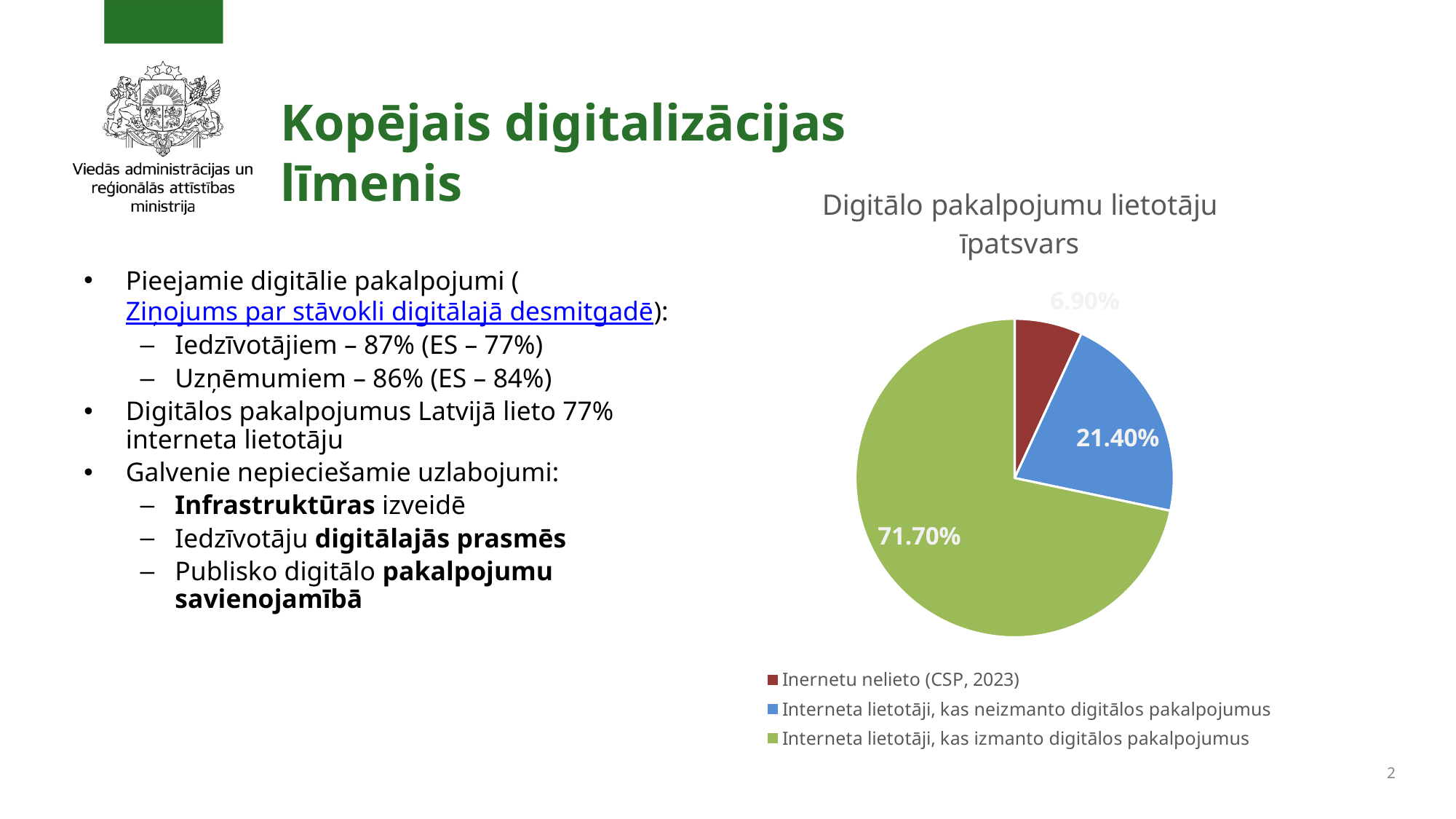
How many slices does the pie chart have? 3 What colour is the slice for 'Interneta lietotāji, kas izmanto digitālos pakalpojumus'? green What is the title of the chart? Digitālo pakalpojumu lietotāju īpatsvars How many entries does the legend list? 3 Which is larger: the slice for 'Interneta lietotāji, kas neizmanto digitālos pakalpojumus' or the slice for 'Inernetu nelieto (CSP, 2023)'? Interneta lietotāji, kas neizmanto digitālos pakalpojumus Which category has the largest slice of the pie? Interneta lietotāji, kas izmanto digitālos pakalpojumus What kind of chart is shown on the slide? pie chart What share of the pie is labelled 'Interneta lietotāji, kas neizmanto digitālos pakalpojumus'? 21.40% What share of the pie is labelled 'Interneta lietotāji, kas izmanto digitālos pakalpojumus'? 71.70% What share of the pie is labelled 'Inernetu nelieto (CSP, 2023)'? 6.90% Which category has the smallest slice of the pie? Inernetu nelieto (CSP, 2023) What is the difference between the share for 'Interneta lietotāji, kas izmanto digitālos pakalpojumus' and 'Interneta lietotāji, kas neizmanto digitālos pakalpojumus'? 50.30%